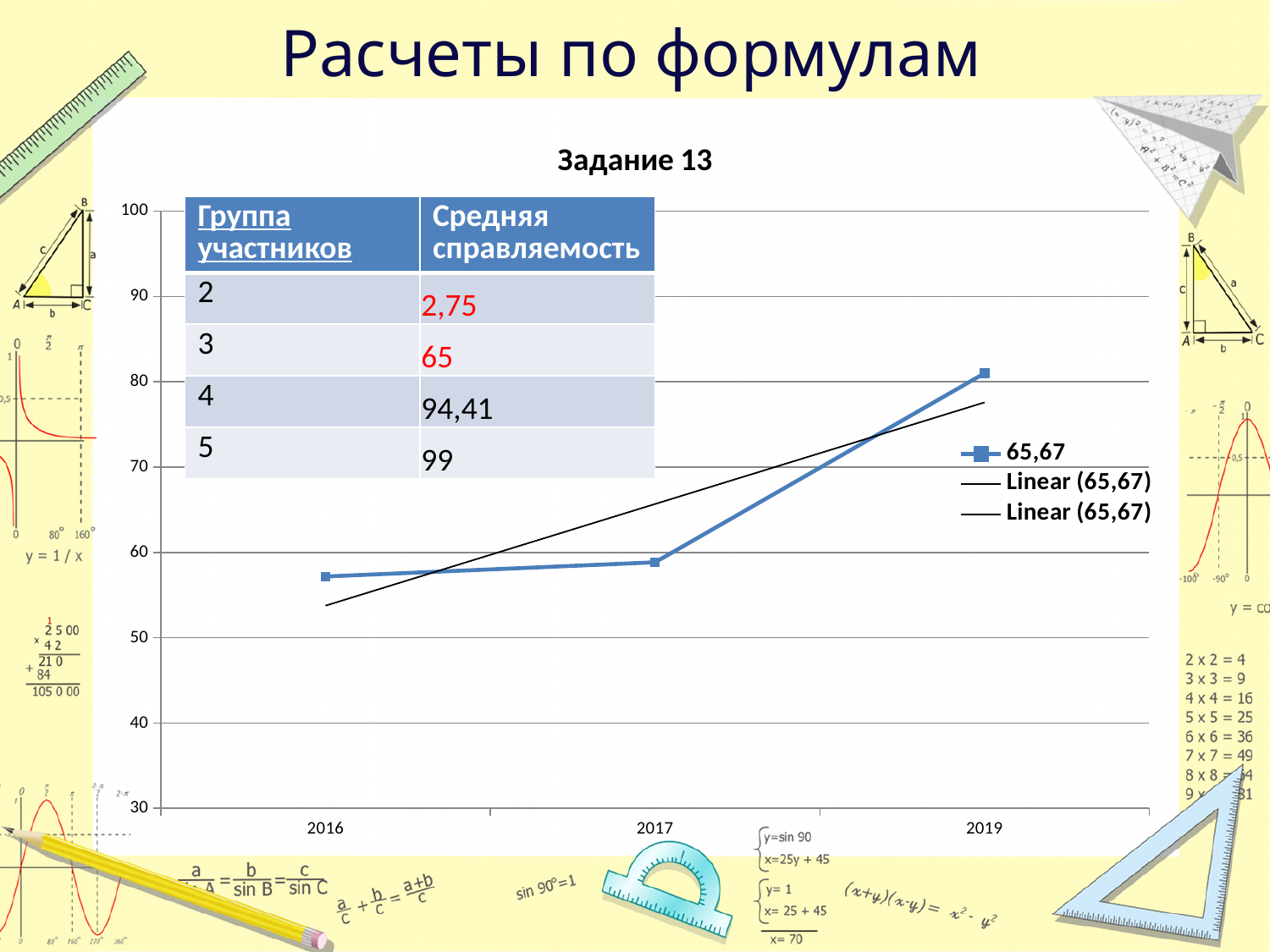
Do the values on the plotted line rise or fall from 2016 to 2019? rise What is the title of the chart? Задание 13 What kind of chart is shown on the slide? line chart What is the name of the data series shown with square markers in the legend? 65,67 What are the years shown on the x axis of the chart? 2016, 2017, 2019 Is the value for 2019 greater or less than 70? greater Which is larger, the value for 2017 or the value for 2019? 2019 How many entries does the chart legend list? 3 How many data points are plotted on the line in the chart? 3 Is the value for 2017 greater or less than 70? less Which year has the highest value on the plotted line? 2019 Is the value for 2016 greater or less than 60? less